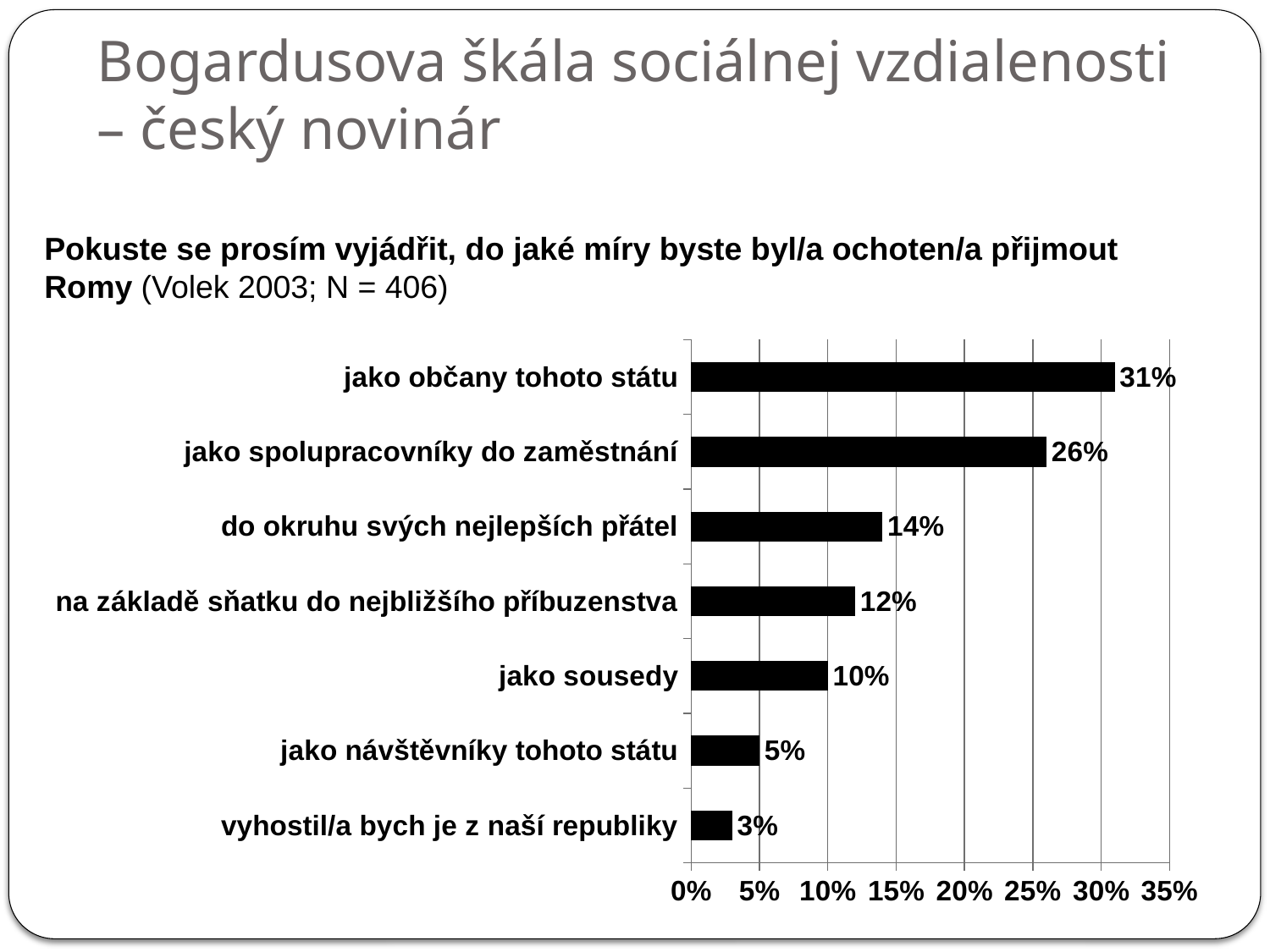
What is the difference between the values for "do okruhu svých nejlepších přátel" and "jako návštěvníky tohoto státu"? 9% What is the maximum value shown on the horizontal axis? 35% Which category has the highest value? jako občany tohoto státu How many categories are shown in the chart? 7 What is the difference between the values for "jako občany tohoto státu" and "jako spolupracovníky do zaměstnání"? 5% What is the value for "jako občany tohoto státu"? 31% What is the value for "na základě sňatku do nejbližšího příbuzenstva"? 12% Which category has the lowest value? vyhostil/a bych je z naší republiky What is the value for "jako sousedy"? 10% Which is larger: the value for "jako sousedy" or the value for "jako návštěvníky tohoto státu"? jako sousedy What kind of chart is shown on the slide? bar chart Is the value for "jako spolupracovníky do zaměstnání" greater or less than 25%? greater